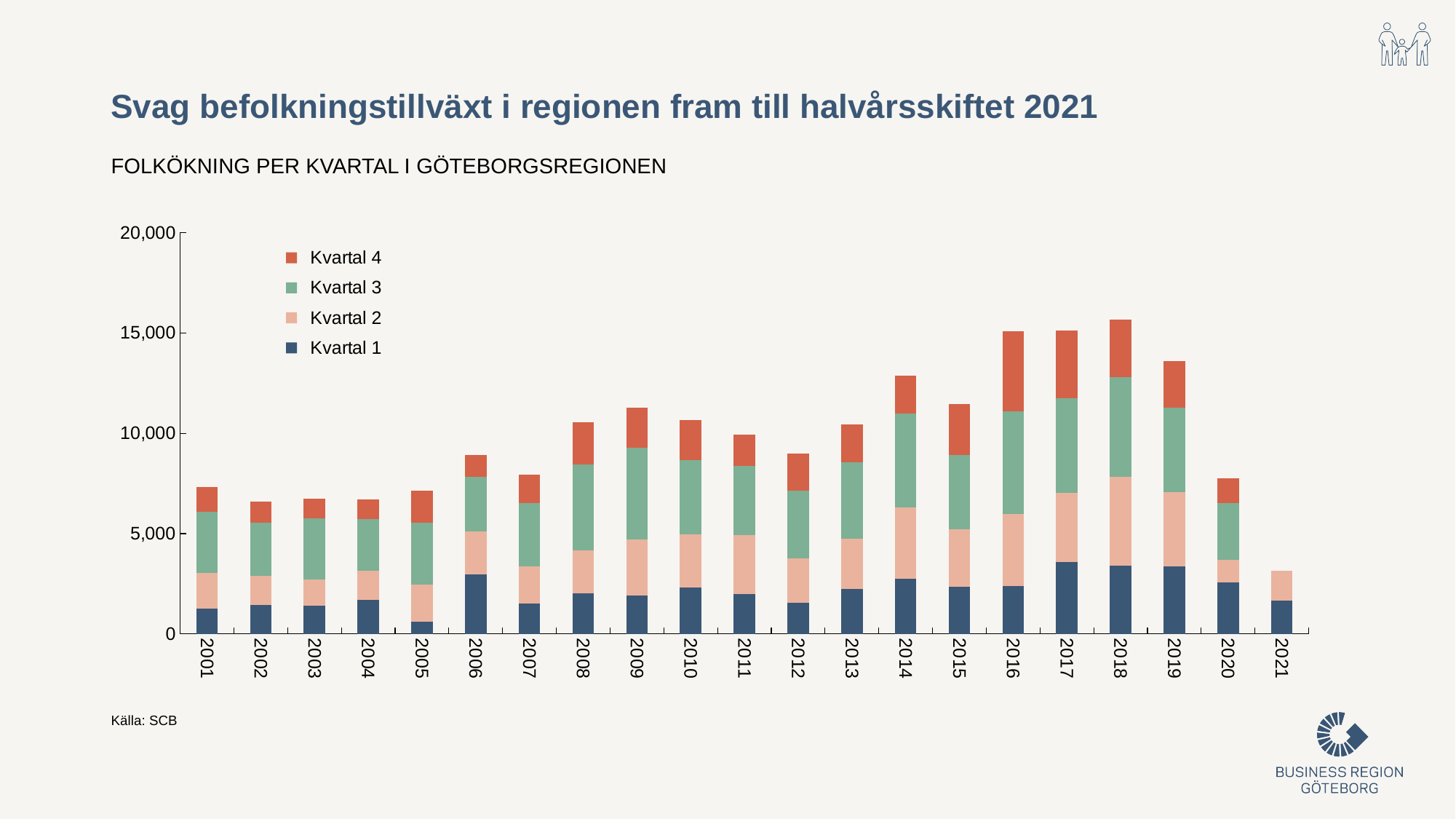
What kind of chart is shown on the slide? Stacked bar chart Is the total for 2019 greater or less than 15,000? less What is the source cited below the chart? SCB How many years are shown on the x axis? 21 Which year has the highest total bar? 2018 Which year has the lowest total bar? 2021 Which series is shown in the darkest blue at the bottom of each bar? Kvartal 1 Which year has the larger total bar, 2018 or 2020? 2018 Is the total for 2014 greater or less than 10,000? greater Is the total for 2021 greater or less than 5,000? less How many series does the legend list? 4